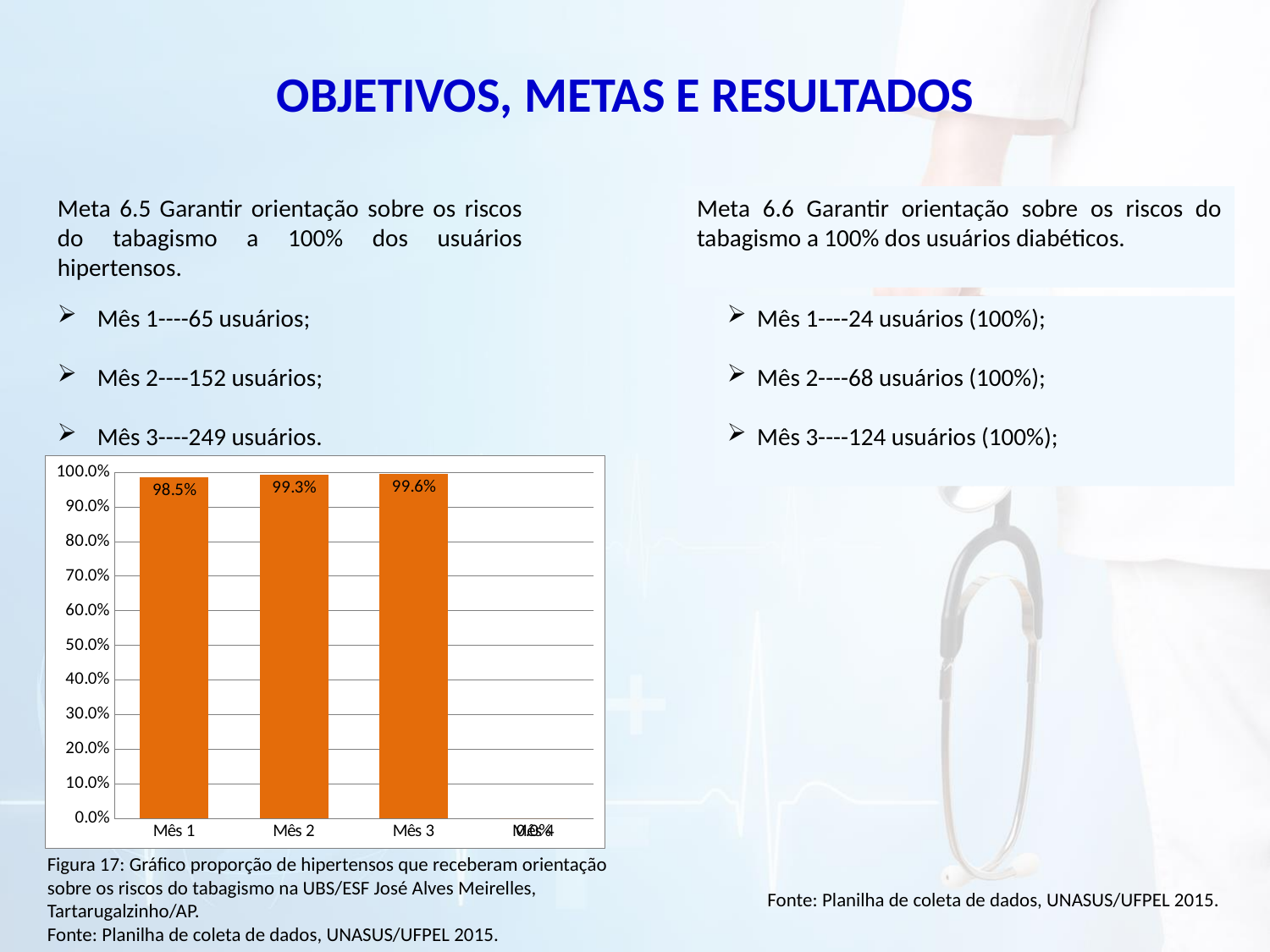
Among Mês 1, Mês 2 and Mês 3, which has the lowest value in the chart? Mês 1 Do the values rise or fall from Mês 1 to Mês 3 in the chart? Rise What is the value shown for Mês 3 in the chart? 99.6% What is the value shown for Mês 2 in the chart? 99.3% Which is larger in the chart, the value for Mês 2 or the value for Mês 3? Mês 3 Which month has the highest value in the chart? Mês 3 What is the difference between the values for Mês 2 and Mês 1 in the chart? 0.8 percentage points What is the value shown for Mês 1 in the chart? 98.5% Is the value for Mês 1 greater or less than 90.0%? greater What is the difference between the values for Mês 3 and Mês 1 in the chart? 1.1 percentage points What colour are the bars in the chart? Orange What kind of chart is shown on the slide? Bar chart